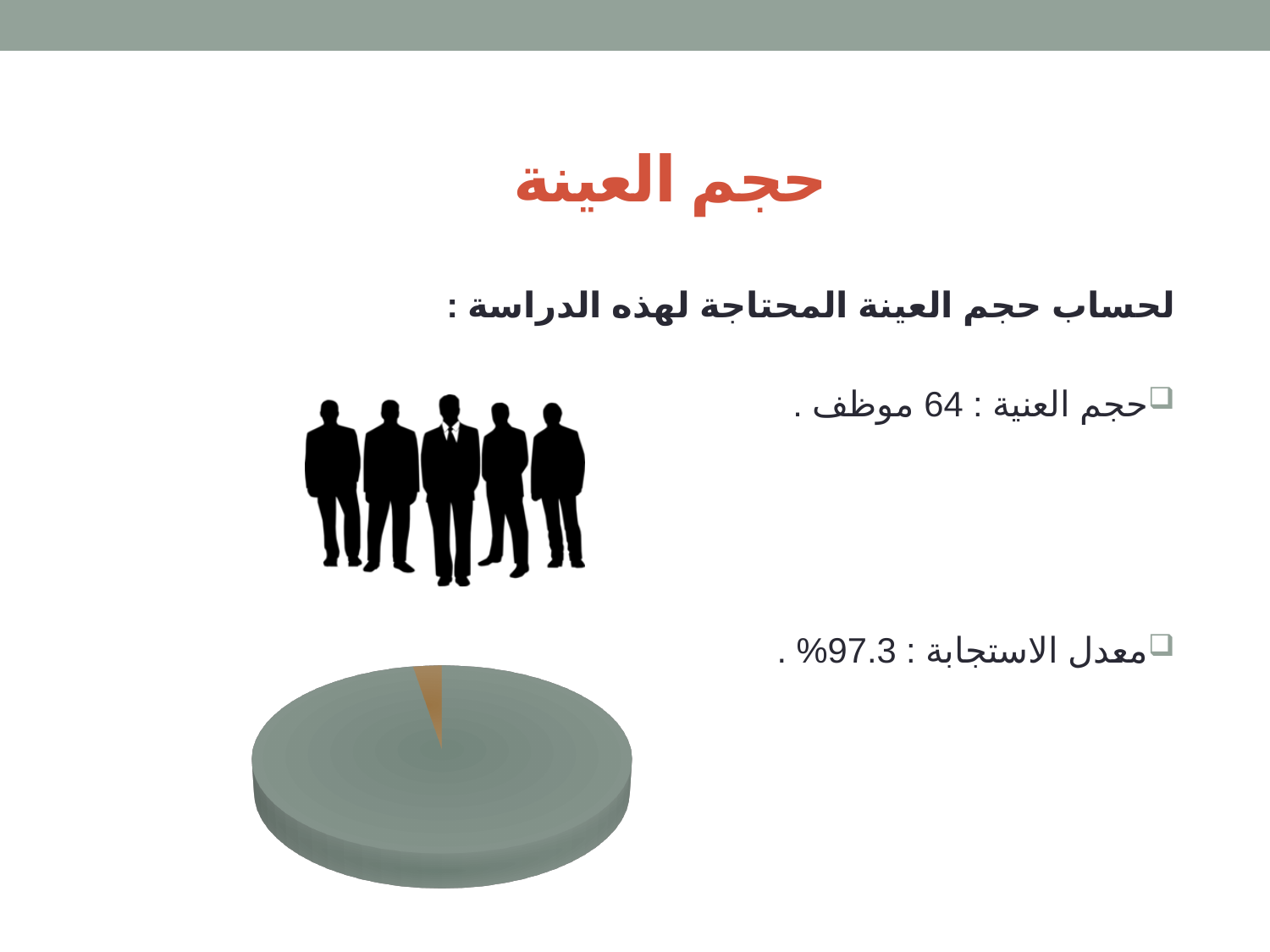
How many slices does the pie chart have? 2 Does the orange slice take up more or less than half of the pie chart? less Is the pie chart drawn in 3D? Yes Does the grey-green slice take up more or less than half of the pie chart? more What colour is the smallest slice of the pie chart? orange What kind of chart is shown at the bottom left of the slide? pie chart Does the pie chart display a legend? No Which slice of the pie chart is larger, the grey-green slice or the orange slice? the grey-green slice What colour is the largest slice of the pie chart? grey-green